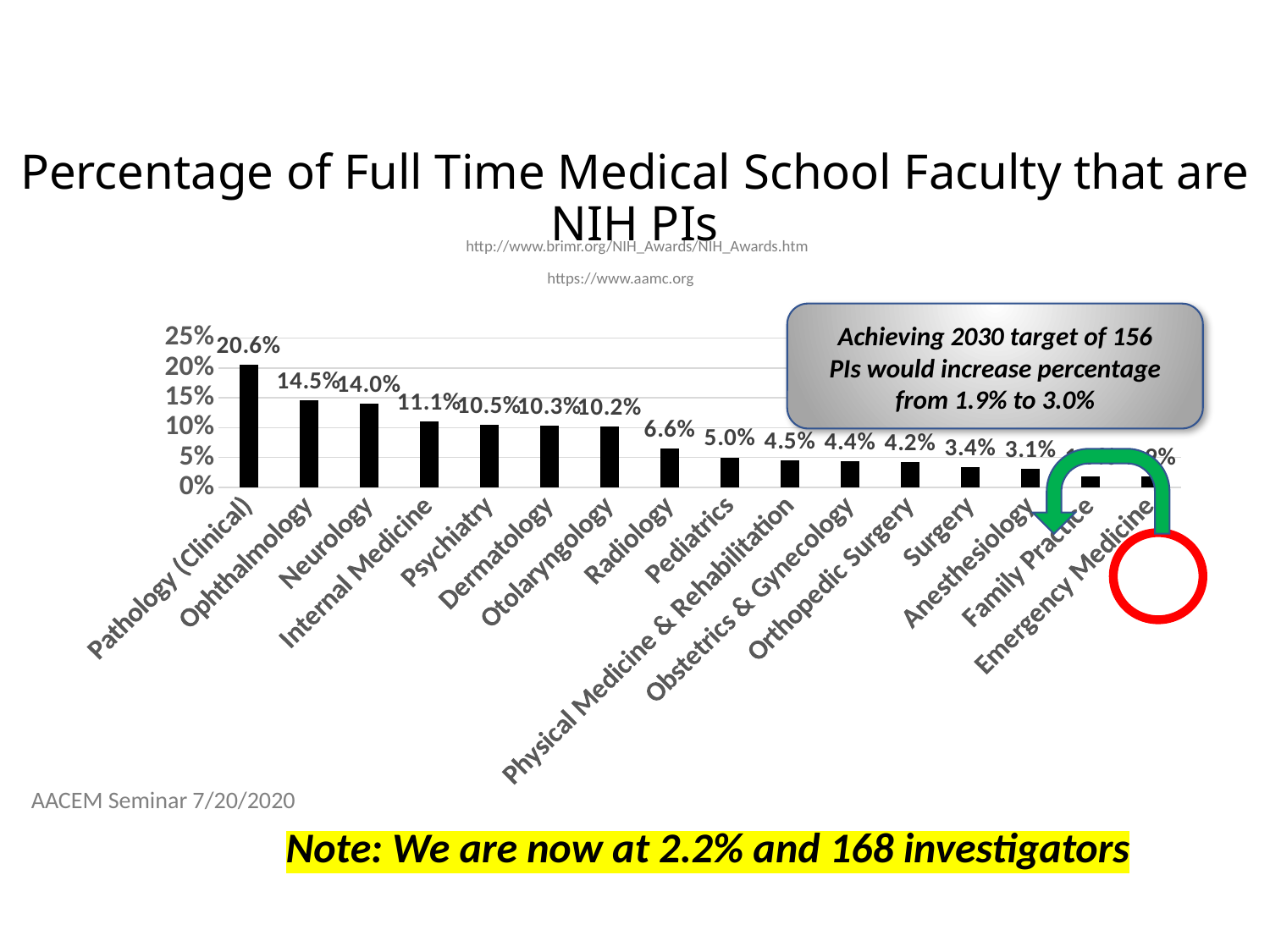
What is the value shown for Anesthesiology? 3.1% What percentage of full time medical school faculty are NIH PIs in Pathology (Clinical)? 20.6% Which specialty has the highest percentage of faculty that are NIH PIs? Pathology (Clinical) Which has a larger value, Neurology or Psychiatry? Neurology What type of chart is shown on the slide? bar chart How many specialties are shown on the x axis of the chart? 16 What is the value shown for Radiology? 6.6% What is the value shown for Ophthalmology? 14.5% Do the values rise or fall moving from left to right along the x axis? fall What is the difference between the values for Internal Medicine and Pediatrics? 6.1% Is the value for Emergency Medicine greater or less than 5%? less What is the difference between the values for Pathology (Clinical) and Ophthalmology? 6.1%